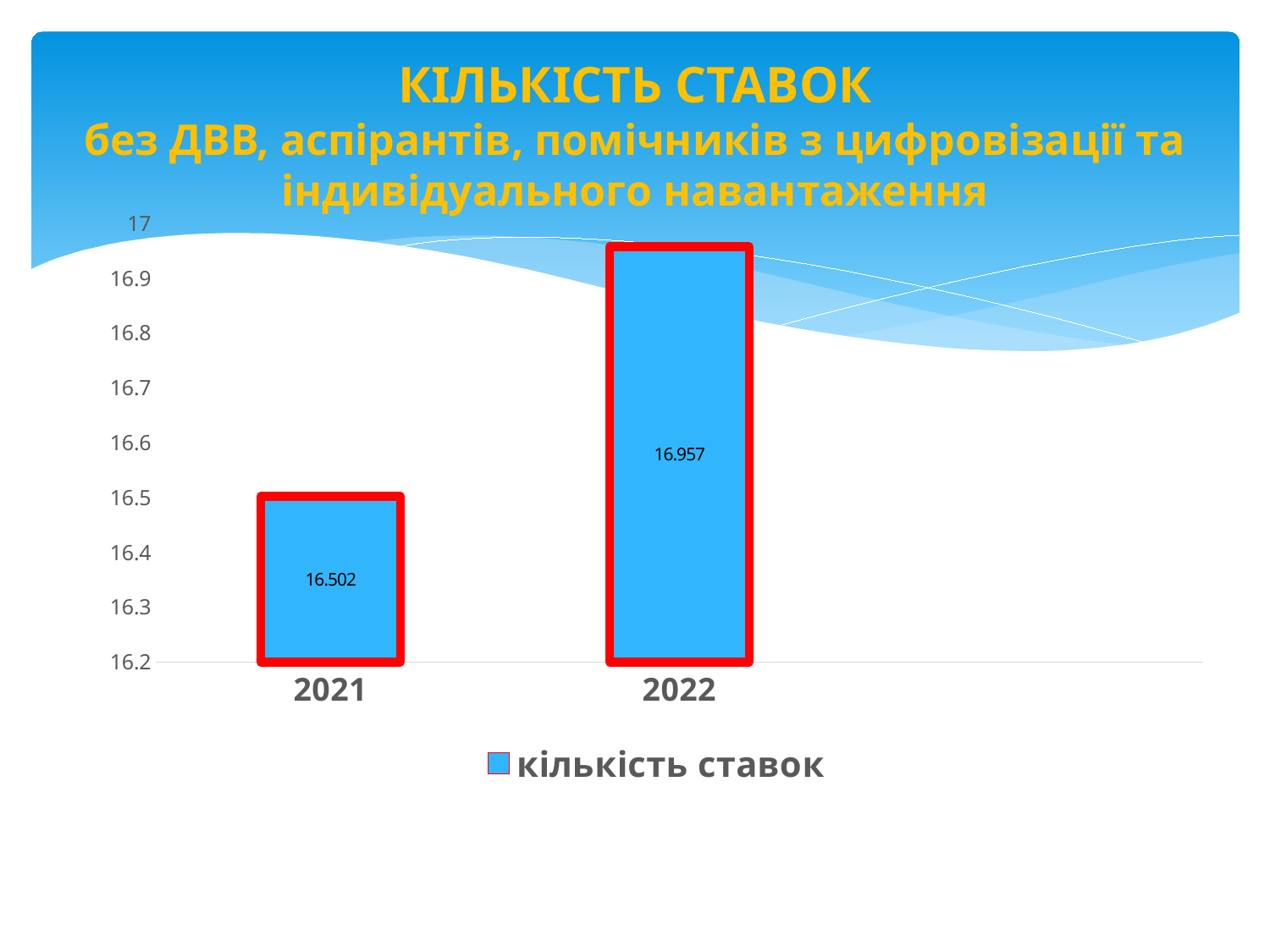
What is the value for 2021? 16.502 Is the value for 2021 greater or less than 16.6? less What kind of chart is shown on the slide? bar chart Is the value for 2022 greater or less than 16.8? greater How many series does the legend list? 1 Do the values rise or fall from 2021 to 2022? rise What is the value for 2022? 16.957 Which year has the lowest value? 2021 Which year has the highest value? 2022 How many categories are shown on the x axis? 2 Which is larger, the value for 2021 or the value for 2022? 2022 What is the difference between the values for 2022 and 2021? 0.455